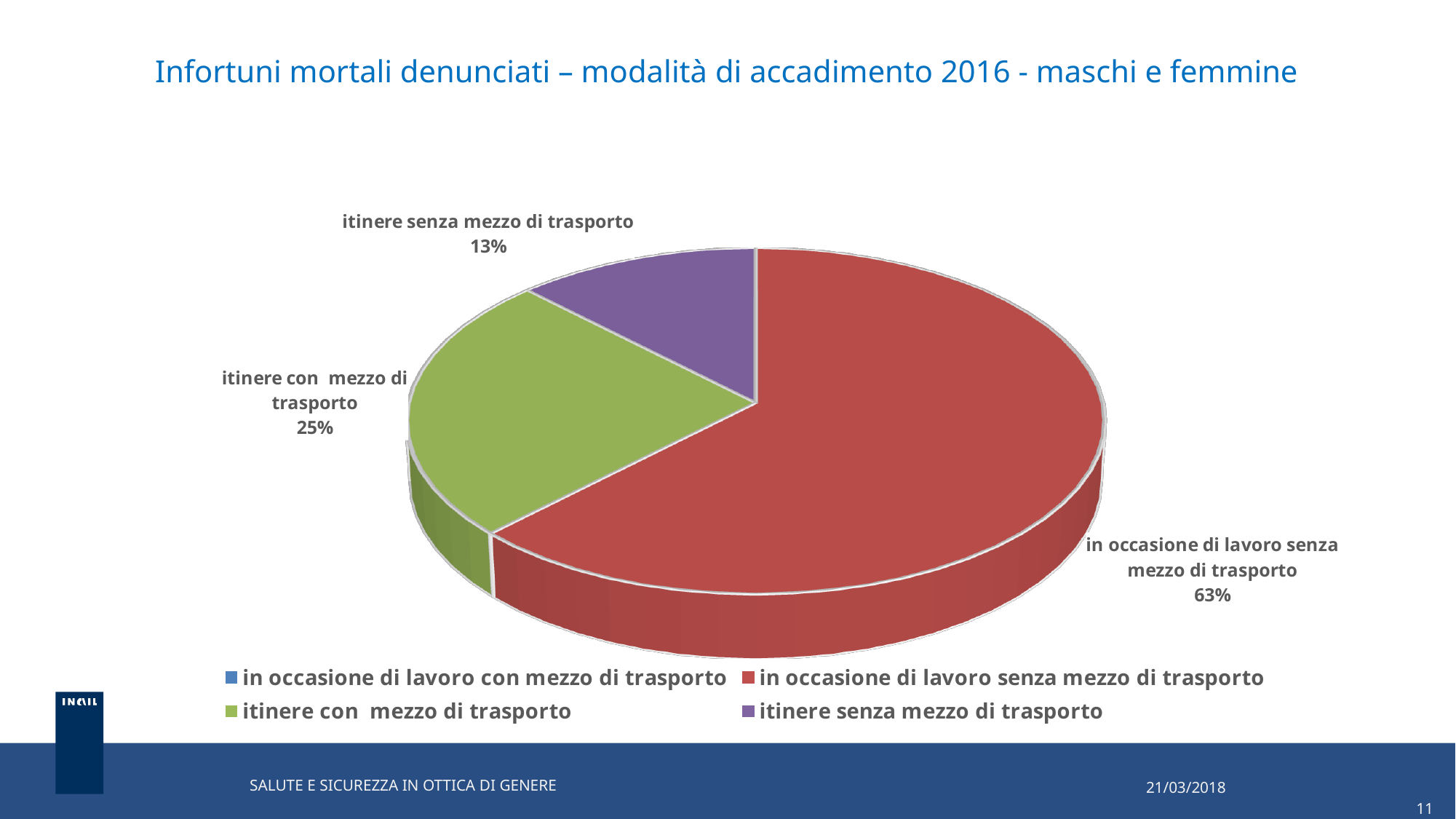
What share of the pie does 'itinere senza mezzo di trasporto' represent? 13% What percentage is shown for 'itinere con mezzo di trasporto'? 25% What percentage is shown for 'in occasione di lavoro senza mezzo di trasporto'? 63% Which category has the largest slice of the pie? in occasione di lavoro senza mezzo di trasporto How many slices have a percentage label on the pie? 3 What is the difference in percentage points between 'itinere con mezzo di trasporto' and 'itinere senza mezzo di trasporto'? 12% Which of the labelled slices is the smallest? itinere senza mezzo di trasporto What is the difference in percentage points between 'in occasione di lavoro senza mezzo di trasporto' and 'itinere con mezzo di trasporto'? 38% How many entries does the legend list? 4 What kind of chart is shown on the slide? pie chart What colour is the slice for 'itinere senza mezzo di trasporto'? purple Which is larger: the slice for 'itinere con mezzo di trasporto' or the slice for 'itinere senza mezzo di trasporto'? itinere con mezzo di trasporto